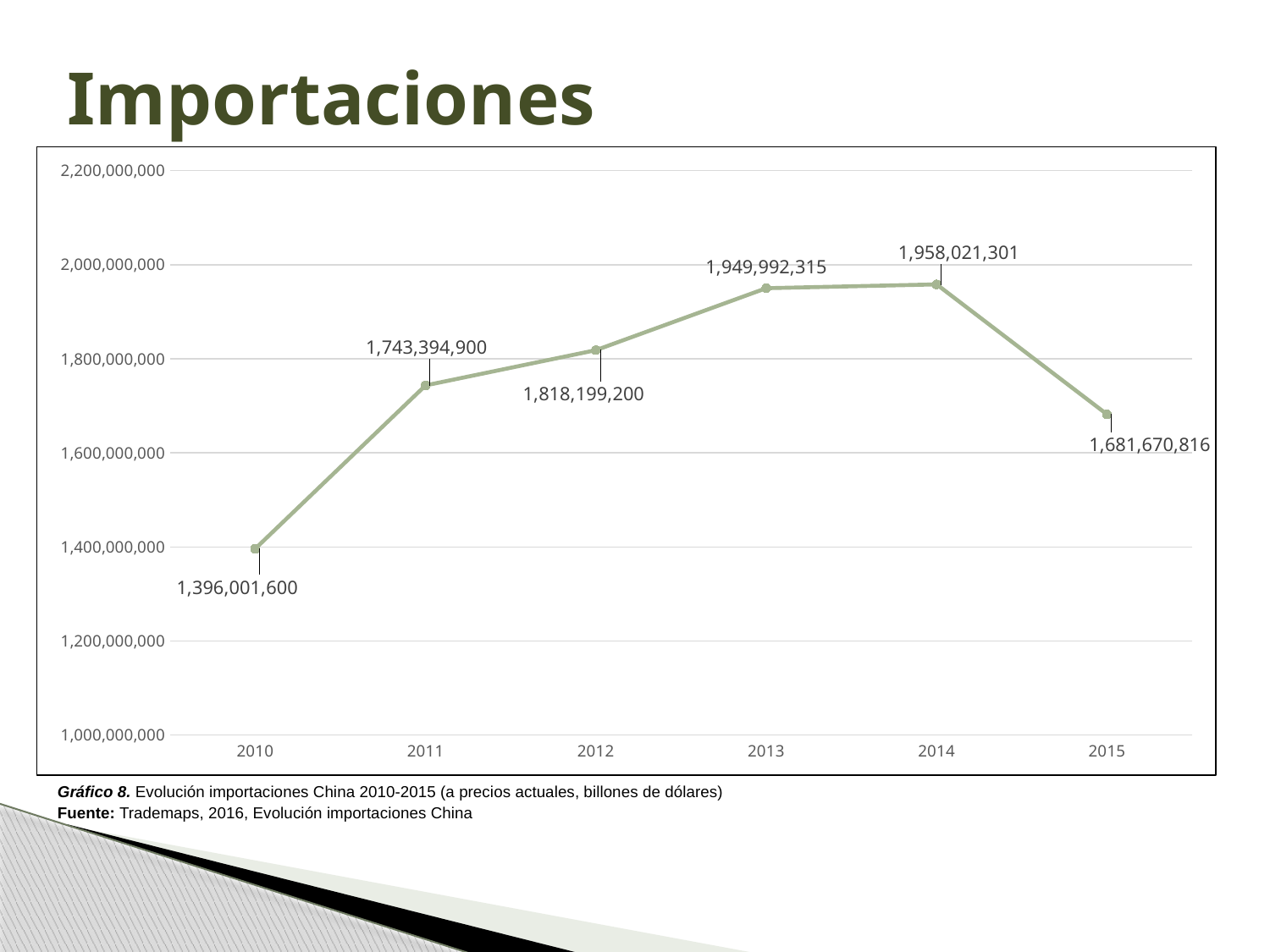
Which year has the lowest value? 2010 What kind of chart is shown on the slide? line chart What is the difference between the values for 2014 and 2015? 276,350,485 What is the value for 2010? 1,396,001,600 How many years are plotted on the chart? 6 What is the value for 2015? 1,681,670,816 What is the value for 2013? 1,949,992,315 Which is larger, the value for 2012 or the value for 2015? 2012 What is the difference between the values for 2011 and 2010? 347,393,300 Do the values rise or fall from 2010 to 2014? rise Which year has the highest value? 2014 Is the value for 2012 greater or less than 1,800,000,000? greater